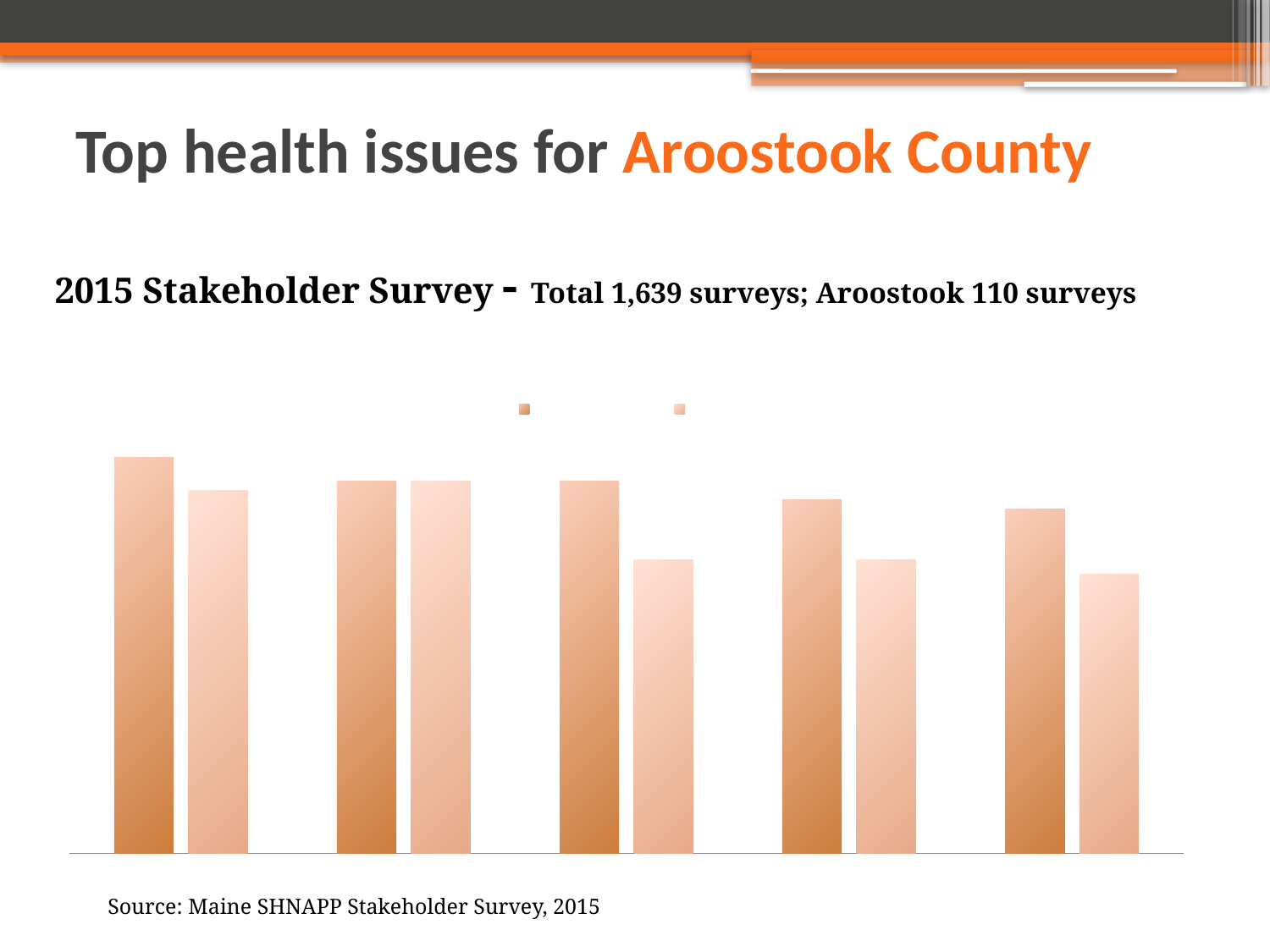
What kind of chart is shown on the slide? bar chart How many groups of bars (categories) are plotted in the chart? 5 How many series does the chart's legend list? 2 Which group of bars, counting from the left, contains the shortest bar in the chart? the fifth group Which group of bars, counting from the left, contains the tallest bar in the chart? the first group How many bars are plotted in total in the chart? 10 What source is cited below the chart? Maine SHNAPP Stakeholder Survey, 2015 Are the bars in the chart vertical or horizontal? vertical In the leftmost group of bars, which bar is taller, the darker orange bar or the lighter orange bar? the darker orange bar In the rightmost group of bars, which bar is taller, the darker orange bar or the lighter orange bar? the darker orange bar In the middle (third) group of bars, which bar is taller, the darker orange bar or the lighter orange bar? the darker orange bar